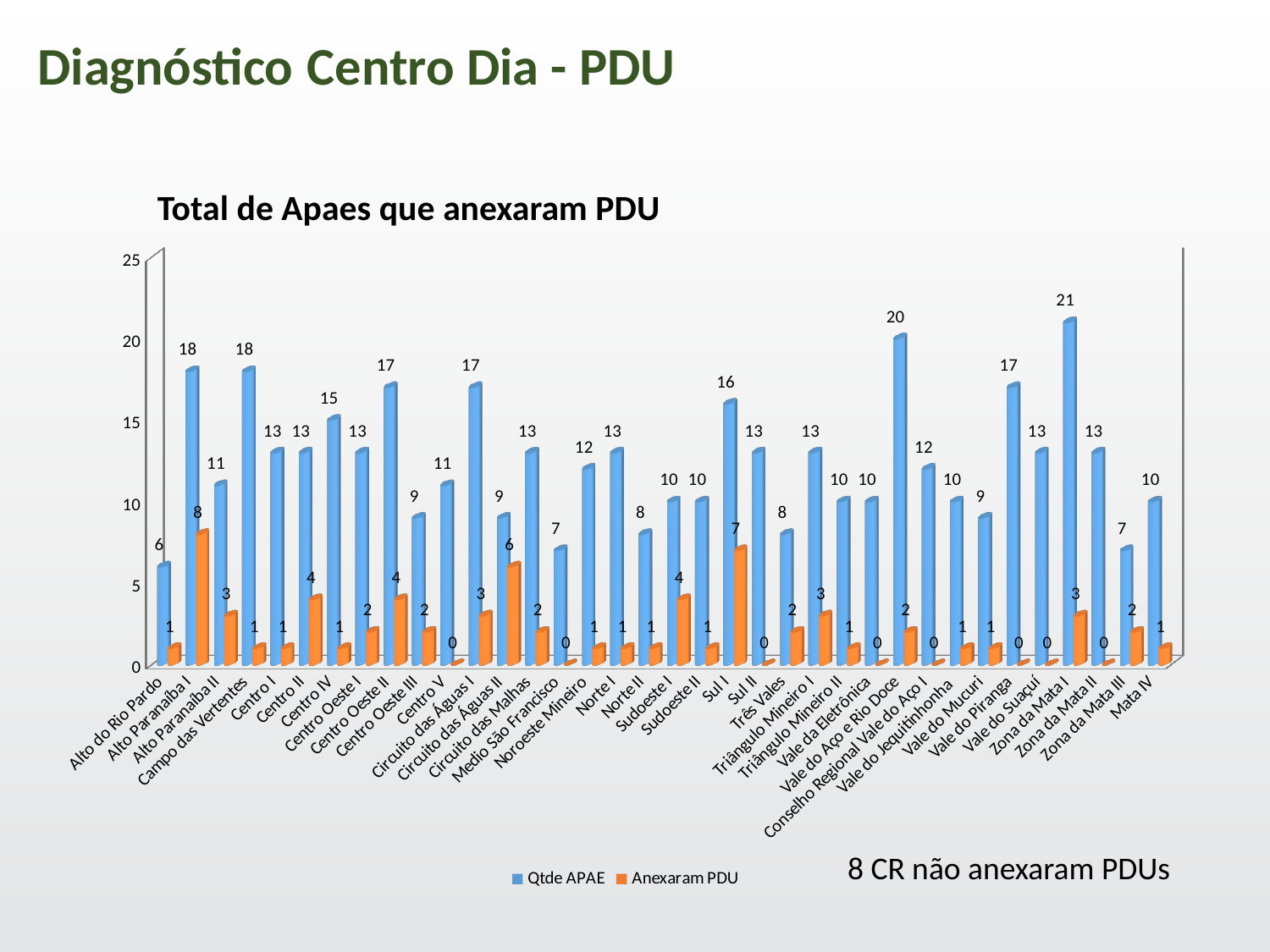
Which is larger: the Qtde APAE value for Centro IV or for Centro Oeste II? Centro Oeste II What is the Anexaram PDU value for Alto Paranaíba I? 8 Which category has the highest Qtde APAE value? Zona da Mata I What is the difference between the Qtde APAE and Anexaram PDU values for Vale do Aço e Rio Doce? 18 What is the title of the chart? Total de Apaes que anexaram PDU How many series does the legend list? 2 What is the Qtde APAE value for Zona da Mata I? 21 Which category has the lowest Qtde APAE value? Alto do Rio Pardo Which series is shown in orange? Anexaram PDU Which category has the highest Anexaram PDU value? Alto Paranaíba I What is the Anexaram PDU value for Sul I? 7 What kind of chart is shown on the slide? Bar chart